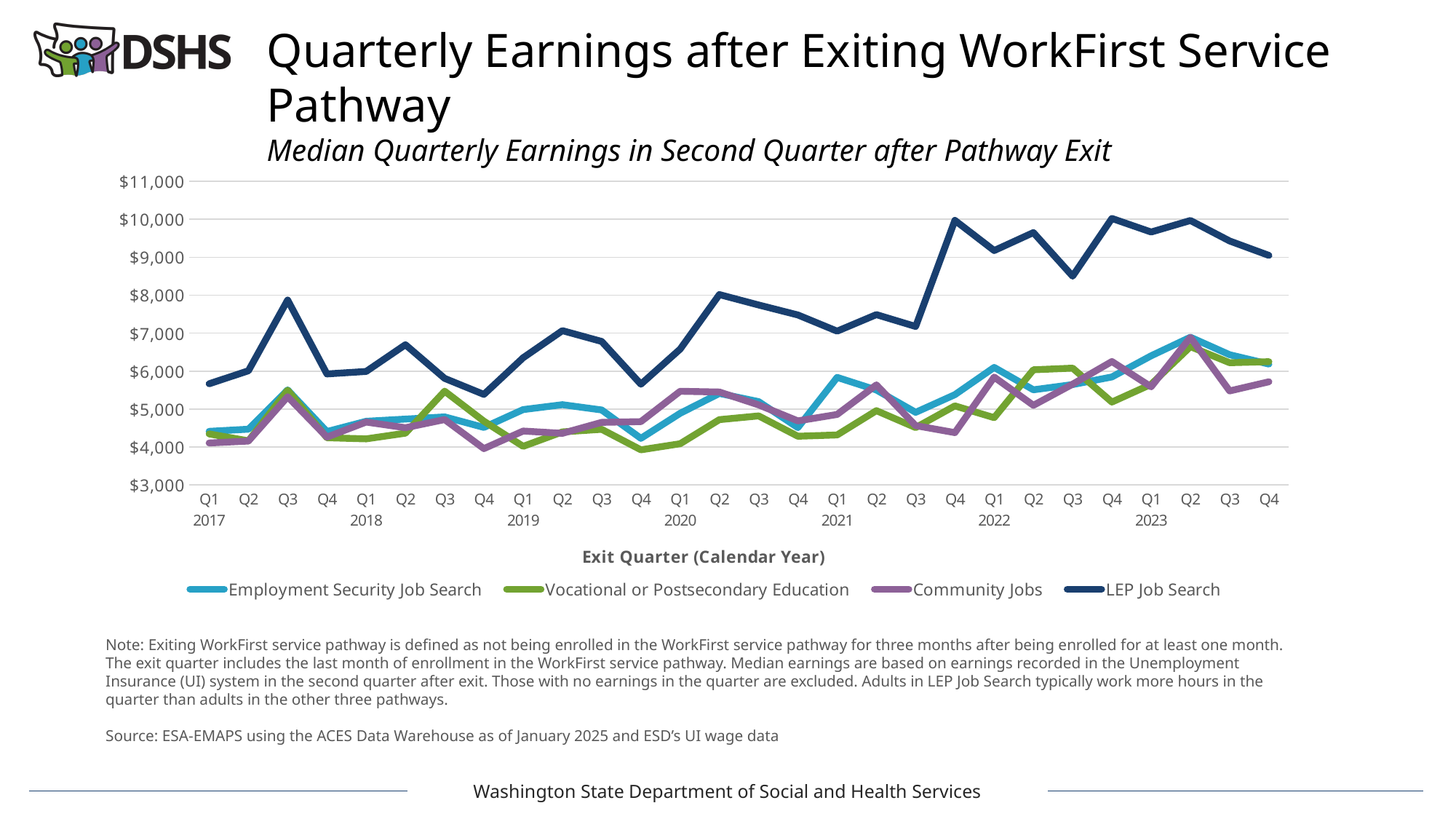
In Q4 2023, which is larger: LEP Job Search or Employment Security Job Search? LEP Job Search Is the value for LEP Job Search in Q1 2017 greater or less than $6,000? less Is the value for LEP Job Search in Q3 2017 greater or less than $7,000? greater How many exit quarters are plotted along the x axis? 28 How many series does the legend list? 4 Is the value for LEP Job Search in Q3 2022 greater or less than $9,000? less Does the LEP Job Search line generally rise or fall from 2017 to 2023? Rise Which series has the highest median quarterly earnings across the whole period? LEP Job Search What kind of chart is shown on the slide? Line chart What is the label of the x axis? Exit Quarter (Calendar Year)